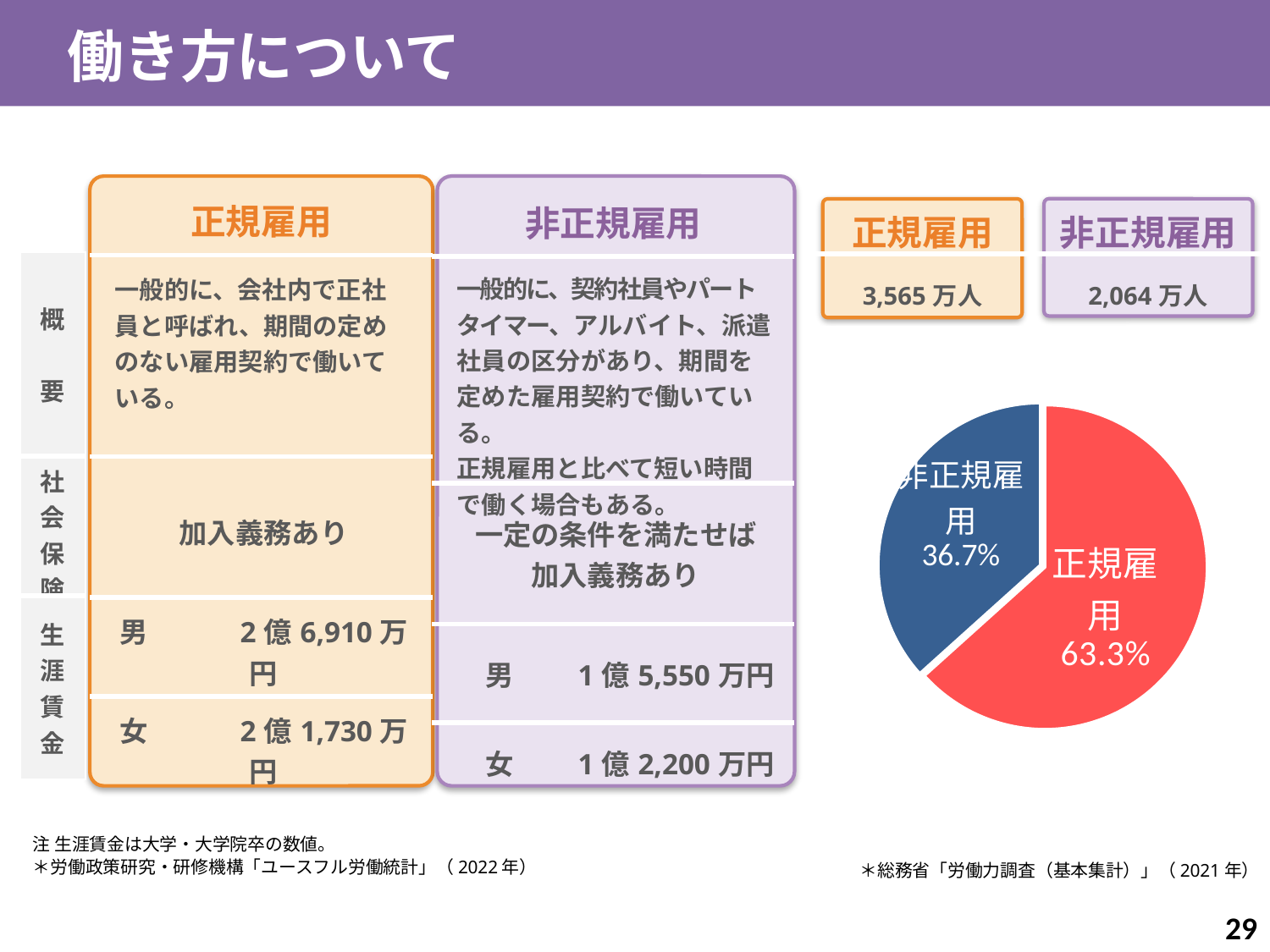
By how many percentage points does the 正規雇用 share exceed the 非正規雇用 share in the pie chart? 26.6 percentage points What kind of chart is shown on the slide? Pie chart Which slice of the pie chart is the smallest? 非正規雇用 Which slice of the pie chart is the largest? 正規雇用 Is the share for 非正規雇用 in the pie chart greater or less than 50%? less Is the share for 正規雇用 in the pie chart greater or less than 60%? greater What colour is the 正規雇用 slice in the pie chart? Red Which is larger in the pie chart, the 正規雇用 slice or the 非正規雇用 slice? 正規雇用 How many slices does the pie chart have? 2 In the pie chart, what share is shown for 正規雇用? 63.3% In the pie chart, what share is shown for 非正規雇用? 36.7% What colour is the 非正規雇用 slice in the pie chart? Blue